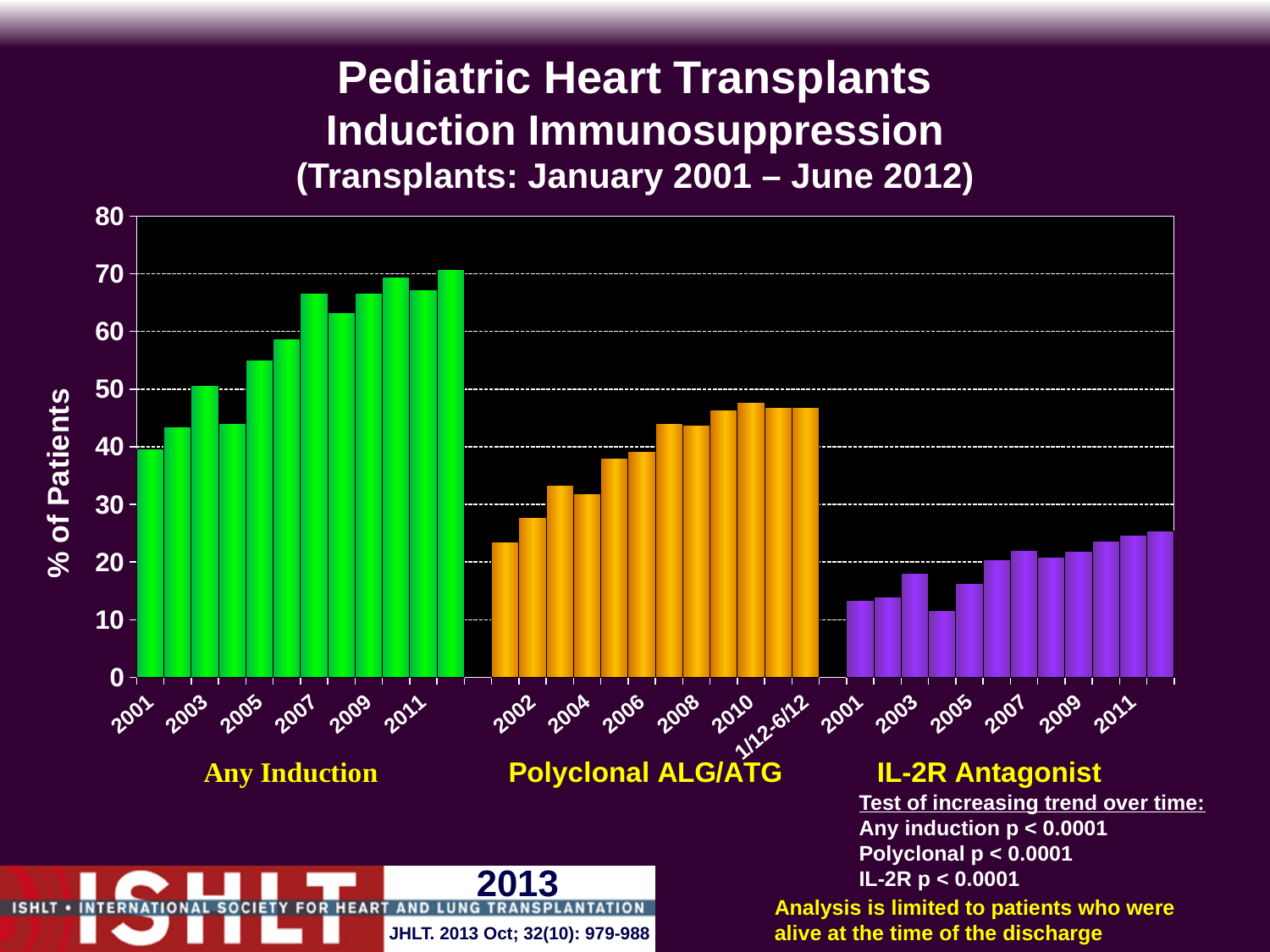
Do the values for Any Induction generally rise or fall from 2001 to 1/12-6/12? rise What kind of chart is shown on the slide? bar chart Is the value for Polyclonal ALG/ATG in 2010 greater or less than 50? less What is the label on the y axis of the chart? % of Patients Is the value for IL-2R Antagonist in 2011 greater or less than 20? greater Which year has the lowest value in the Any Induction group? 2001 Is the value for Polyclonal ALG/ATG in 2001 greater or less than 20? greater How many induction groups are shown on the chart? 3 In 2005, which is larger: the value for Any Induction or the value for Polyclonal ALG/ATG? Any Induction How many bars are plotted in the Any Induction group? 12 Which year has the lowest value in the IL-2R Antagonist group? 2004